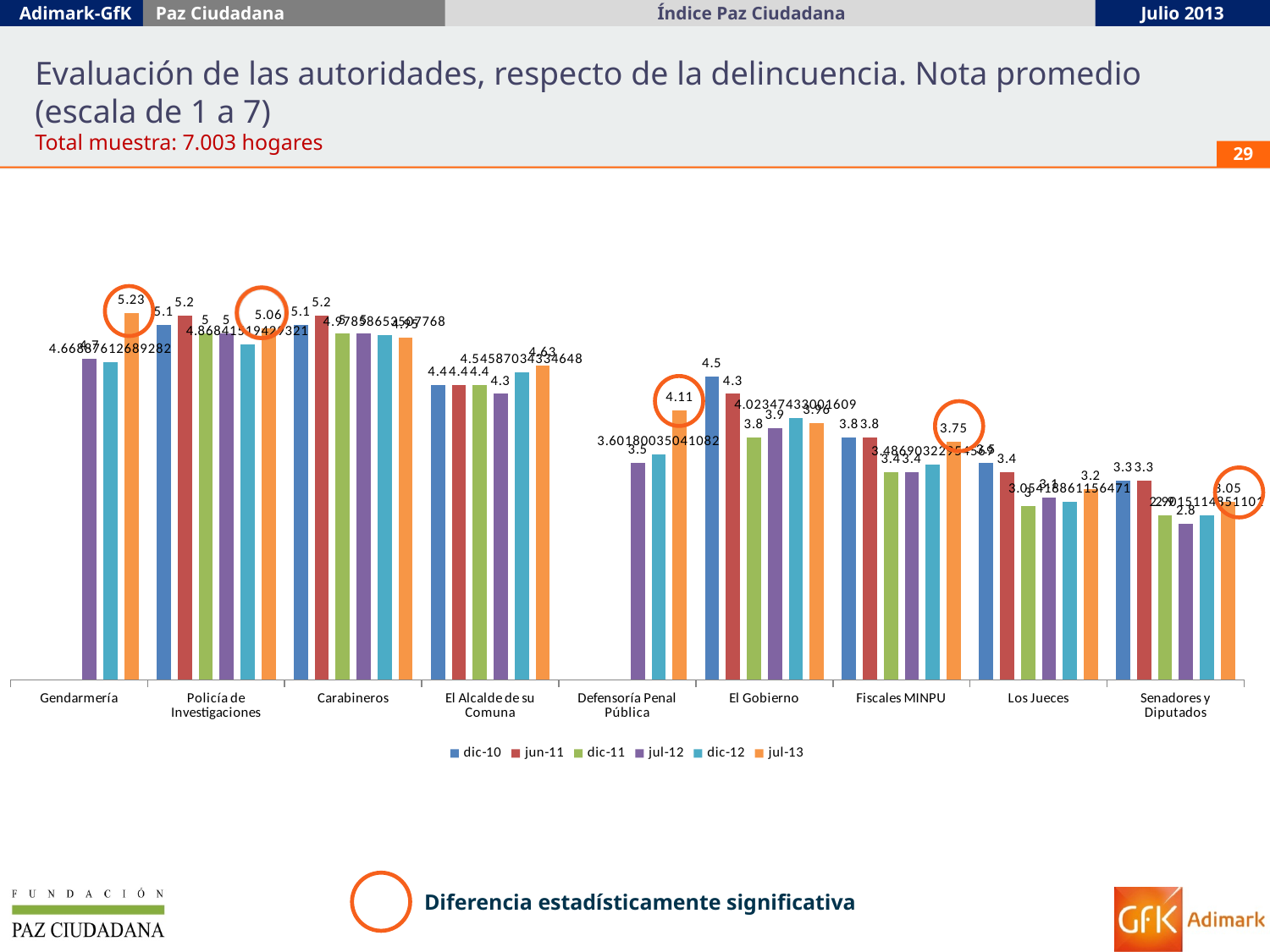
What is the jul-13 value for Policía de Investigaciones? 5.06 What is the difference between the jul-13 values for Gendarmería and Fiscales MINPU? 1.48 What is the jul-13 value for Defensoría Penal Pública? 4.11 What is the jul-13 value for Gendarmería? 5.23 What is the jul-13 value for Fiscales MINPU? 3.75 Which category has the lowest jul-13 value? Senadores y Diputados For El Gobierno, which is larger: the dic-10 value or the jun-11 value? dic-10 What is the jul-12 value for Senadores y Diputados? 2.8 What is the dic-10 value for El Gobierno? 4.5 How many categories are shown on the x axis? 9 Which category has the highest jul-13 value? Gendarmería How many series does the legend list? 6